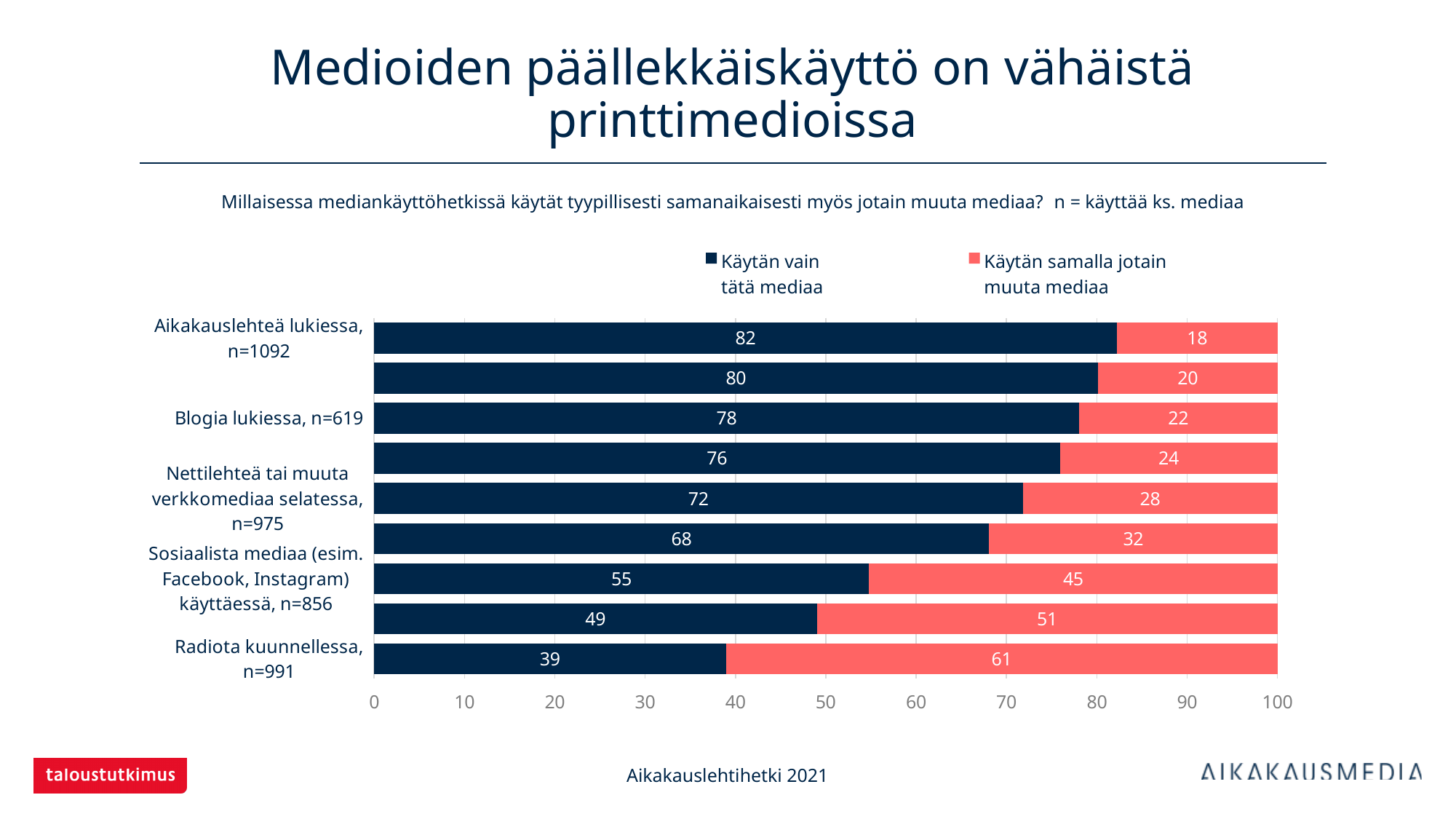
Which is larger: the "Käytän samalla jotain muuta mediaa" value for "Blogia lukiessa, n=619" or for "Sosiaalista mediaa (esim. Facebook, Instagram) käyttäessä, n=856"? Sosiaalista mediaa (esim. Facebook, Instagram) käyttäessä, n=856 What is the difference between the "Käytän vain tätä mediaa" values for "Aikakauslehteä lukiessa, n=1092" and "Radiota kuunnellessa, n=991"? 43 How many series does the legend list? 2 What is the value of "Käytän vain tätä mediaa" for "Blogia lukiessa, n=619"? 78 What is the total of the stacked bar for "Radiota kuunnellessa, n=991"? 100 Which labeled category has the lowest value for "Käytän vain tätä mediaa"? Radiota kuunnellessa, n=991 Which labeled category has the highest value for "Käytän vain tätä mediaa"? Aikakauslehteä lukiessa, n=1092 What kind of chart is shown on the slide? Stacked bar chart What is the value of "Käytän vain tätä mediaa" for "Aikakauslehteä lukiessa, n=1092"? 82 What is the value of "Käytän samalla jotain muuta mediaa" for "Radiota kuunnellessa, n=991"? 61 What is the value of "Käytän samalla jotain muuta mediaa" for "Nettilehteä tai muuta verkkomediaa selatessa, n=975"? 28 What is the value of "Käytän vain tätä mediaa" for "Sosiaalista mediaa (esim. Facebook, Instagram) käyttäessä, n=856"? 55